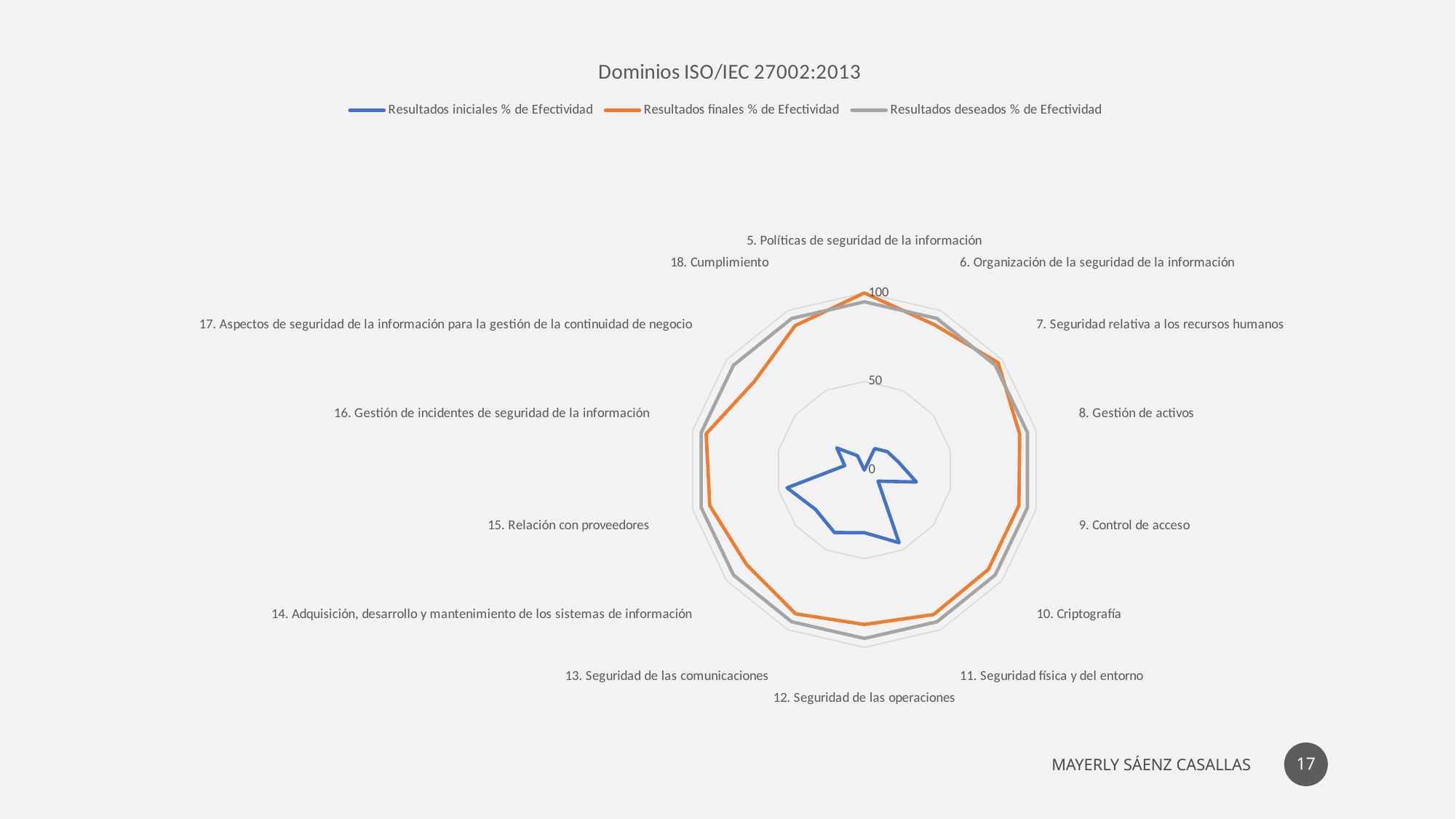
What is the title of the chart? Dominios ISO/IEC 27002:2013 Is the value of 'Resultados iniciales % de Efectividad' for '9. Control de acceso' greater or less than 50? less Is the value of 'Resultados finales % de Efectividad' for '8. Gestión de activos' greater or less than 50? greater How many categories (domains) are plotted around the radar chart? 14 For '15. Relación con proveedores', which series has the larger value: 'Resultados iniciales % de Efectividad' or 'Resultados finales % de Efectividad'? Resultados finales % de Efectividad Is the value of 'Resultados finales % de Efectividad' for '12. Seguridad de las operaciones' greater or less than 50? greater Which colour represents the series 'Resultados finales % de Efectividad'? orange What kind of chart is shown on the slide? radar chart How many series does the legend list? 3 For '18. Cumplimiento', which series has the larger value: 'Resultados iniciales % de Efectividad' or 'Resultados deseados % de Efectividad'? Resultados deseados % de Efectividad